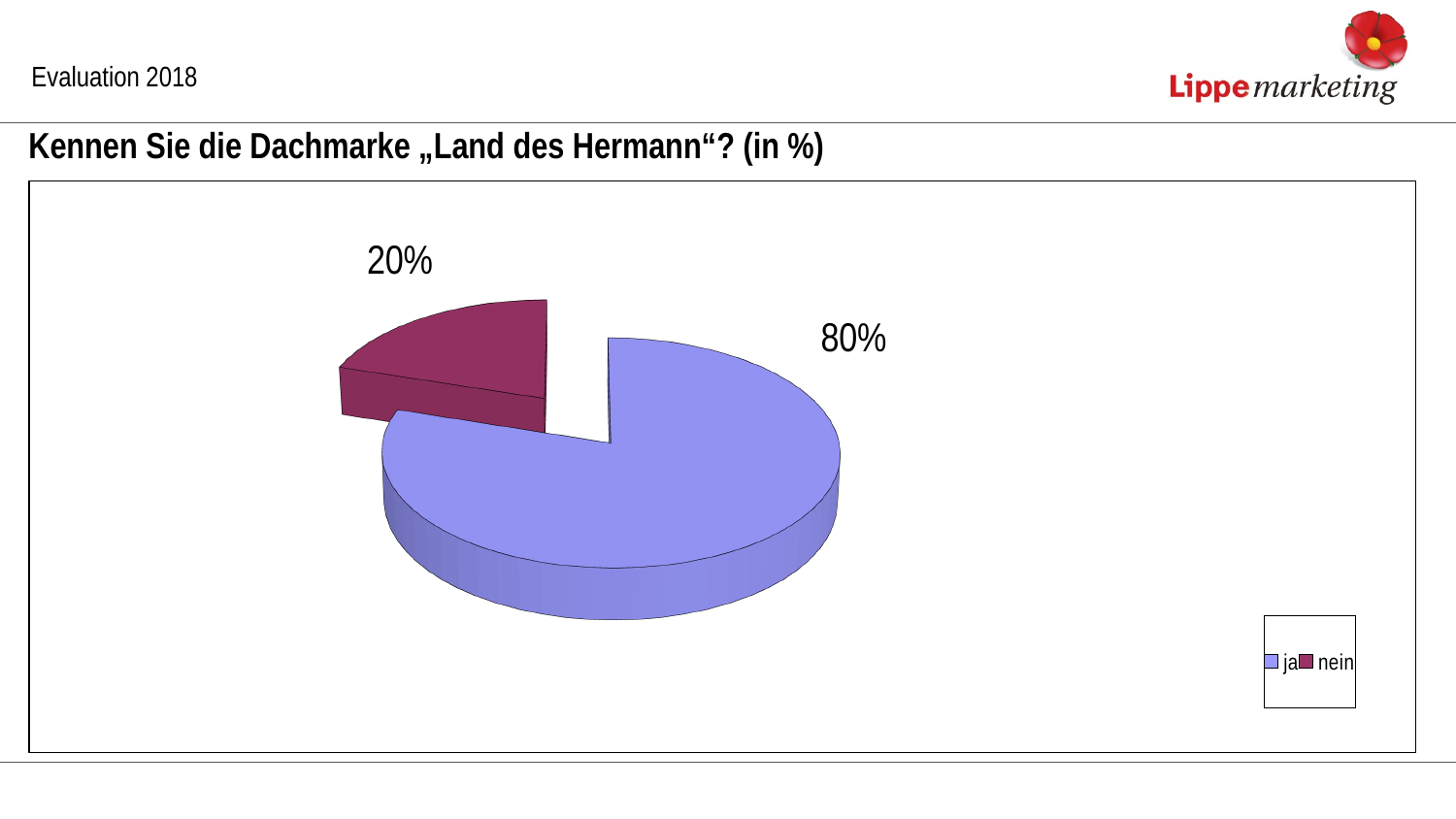
What share of the pie does "ja" have? 80% Which is larger, the "ja" slice or the "nein" slice? ja What is the difference in percentage points between the "ja" and "nein" slices? 60 Which slice is the smallest? nein What is the title of the chart? Kennen Sie die Dachmarke „Land des Hermann“? (in %) How many entries does the legend list? 2 What share of the pie does "nein" have? 20% What kind of chart is shown on the slide? pie chart How many slices does the pie chart have? 2 Which slice is the largest? ja What colour is the "nein" slice? dark red